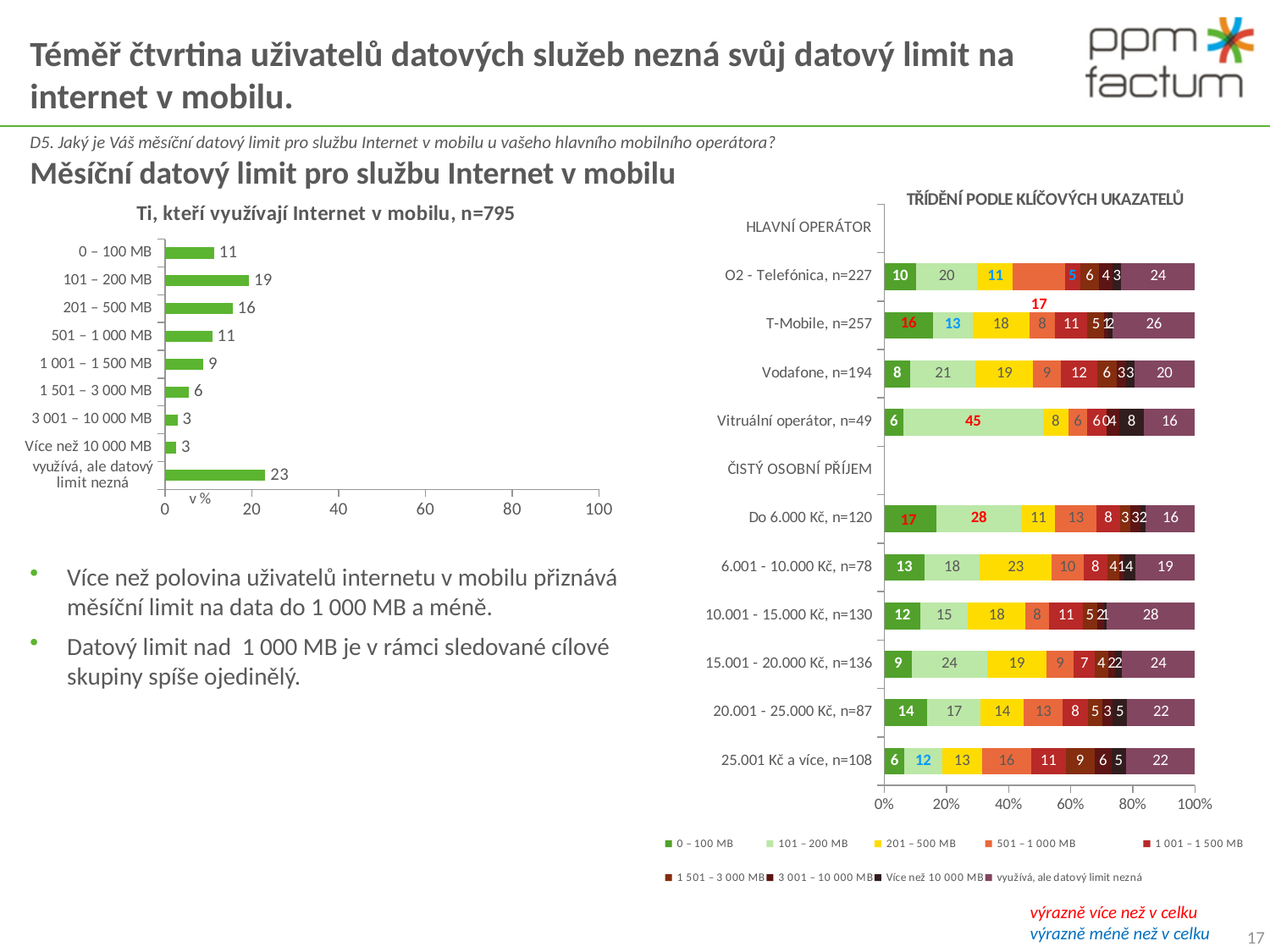
What kind of chart is the left chart 'Ti, kteří využívají Internet v mobilu, n=795'? bar chart In the left chart 'Ti, kteří využívají Internet v mobilu, n=795', which is larger: the value for '0 – 100 MB' or the value for '1 001 – 1 500 MB'? 0 – 100 MB In the left chart 'Ti, kteří využívají Internet v mobilu, n=795', is the value for '1 501 – 3 000 MB' greater or less than 20? less In the left chart 'Ti, kteří využívají Internet v mobilu, n=795', what is the value for '101 – 200 MB'? 19 In the right chart 'TŘÍDĚNÍ PODLE KLÍČOVÝCH UKAZATELŮ', what is the value of the '0 – 100 MB' segment for 'Do 6.000 Kč, n=120'? 17 In the left chart 'Ti, kteří využívají Internet v mobilu, n=795', what is the difference between the values for '101 – 200 MB' and '201 – 500 MB'? 3 In the right chart 'TŘÍDĚNÍ PODLE KLÍČOVÝCH UKAZATELŮ', what is the value of the '101 – 200 MB' segment for 'Vitruální operátor, n=49'? 45 In the left chart 'Ti, kteří využívají Internet v mobilu, n=795', what is the value for 'využívá, ale datový limit nezná'? 23 In the right chart 'TŘÍDĚNÍ PODLE KLÍČOVÝCH UKAZATELŮ', what is the value of the 'využívá, ale datový limit nezná' segment for 'T-Mobile, n=257'? 26 In the right chart 'TŘÍDĚNÍ PODLE KLÍČOVÝCH UKAZATELŮ', how many series does the legend list? 9 In the left chart 'Ti, kteří využívají Internet v mobilu, n=795', how many categories are shown? 9 In the left chart 'Ti, kteří využívají Internet v mobilu, n=795', which category has the highest value? využívá, ale datový limit nezná